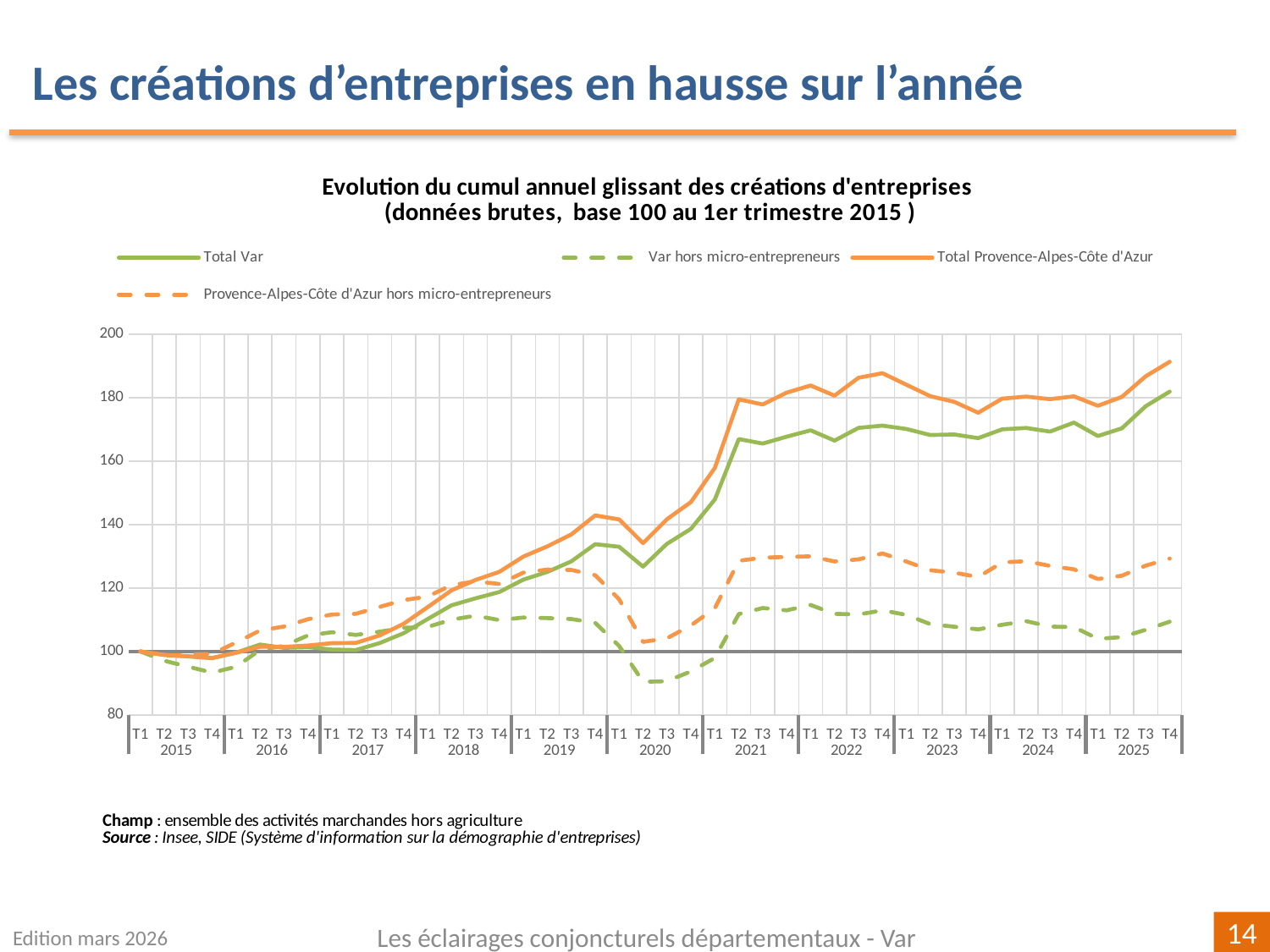
At T4 2025, which is higher: Var hors micro-entrepreneurs or Provence-Alpes-Côte d'Azur hors micro-entrepreneurs? Provence-Alpes-Côte d'Azur hors micro-entrepreneurs Which series is drawn as a dashed orange line? Provence-Alpes-Côte d'Azur hors micro-entrepreneurs What is the title of the chart? Evolution du cumul annuel glissant des créations d'entreprises (données brutes, base 100 au 1er trimestre 2015 ) What kind of chart is shown on the slide? line chart Is the value for Total Var at T2 2021 greater or less than 160? greater Is the value for Var hors micro-entrepreneurs at T3 2020 greater or less than 100? less Is the value for Total Provence-Alpes-Côte d'Azur at T4 2025 greater or less than 180? greater Which series has the lowest value at T3 2020? Var hors micro-entrepreneurs How many series does the legend list? 4 Overall, does the Total Var series rise or fall from T1 2015 to T4 2025? rise At T4 2025, which is higher: Total Var or Total Provence-Alpes-Côte d'Azur? Total Provence-Alpes-Côte d'Azur